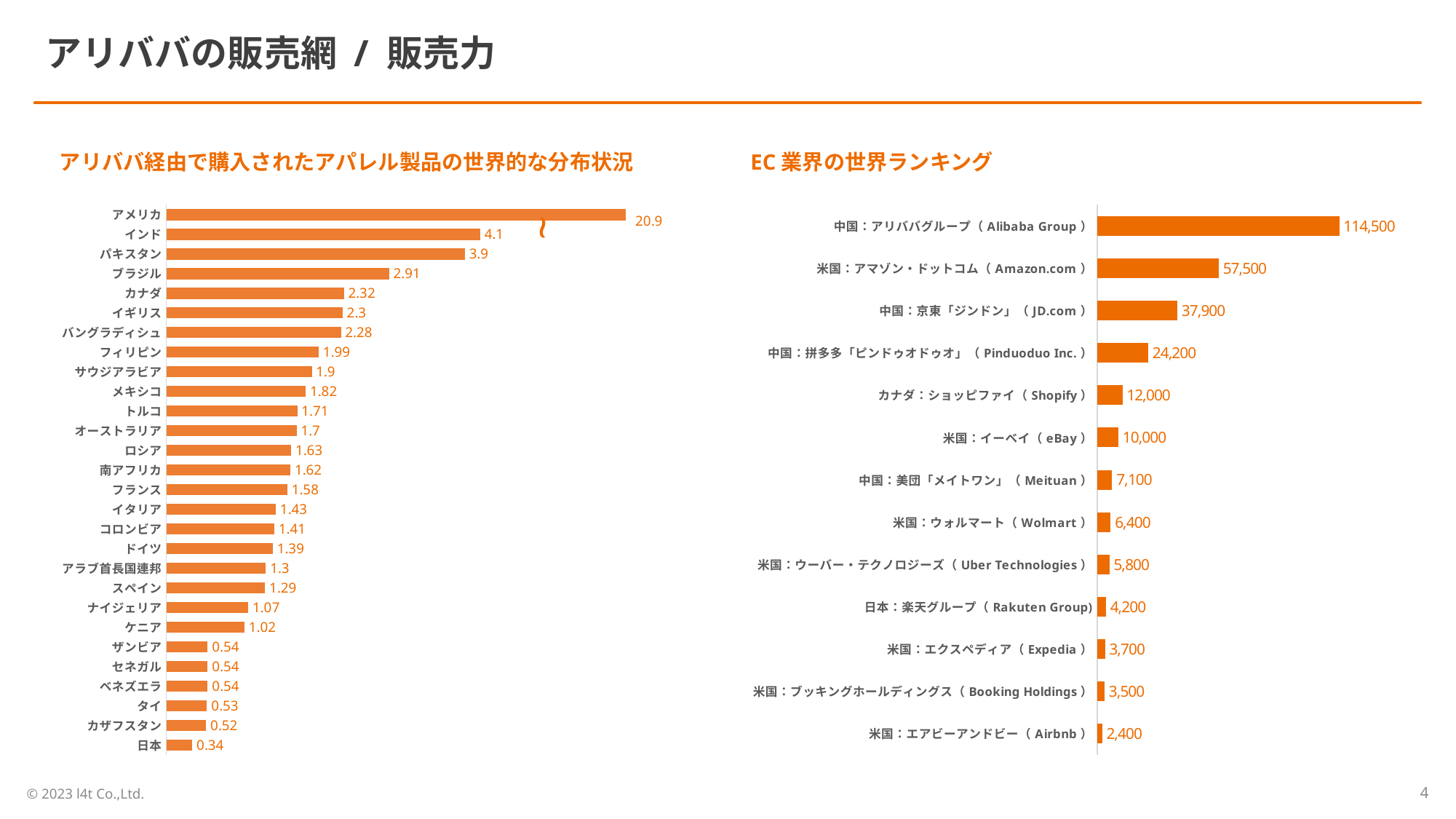
In the chart titled 'アリババ経由で購入されたアパレル製品の世界的な分布状況', what is the value for 日本? 0.34 In the chart titled 'EC 業界の世界ランキング', how many companies are listed? 13 What type of chart is the chart titled 'EC 業界の世界ランキング'? Bar chart In the chart titled 'EC 業界の世界ランキング', what is the value for 日本：楽天グループ（Rakuten Group）? 4,200 In the chart titled 'アリババ経由で購入されたアパレル製品の世界的な分布状況', which country has the lowest value? 日本 In the chart titled 'EC 業界の世界ランキング', which company has the highest value? 中国：アリババグループ（Alibaba Group） In the chart titled 'アリババ経由で購入されたアパレル製品の世界的な分布状況', what is the difference between the values for インド and パキスタン? 0.2 In the chart titled 'アリババ経由で購入されたアパレル製品の世界的な分布状況', how many countries are shown? 28 In the chart titled 'アリババ経由で購入されたアパレル製品の世界的な分布状況', what is the value for アメリカ? 20.9 In the chart titled 'EC 業界の世界ランキング', what is the difference between the values for Alibaba Group and Amazon.com? 57,000 In the chart titled 'EC 業界の世界ランキング', what is the value for 米国：アマゾン・ドットコム（Amazon.com）? 57,500 In the chart titled 'アリババ経由で購入されたアパレル製品の世界的な分布状況', which is larger, the value for ブラジル or the value for カナダ? ブラジル